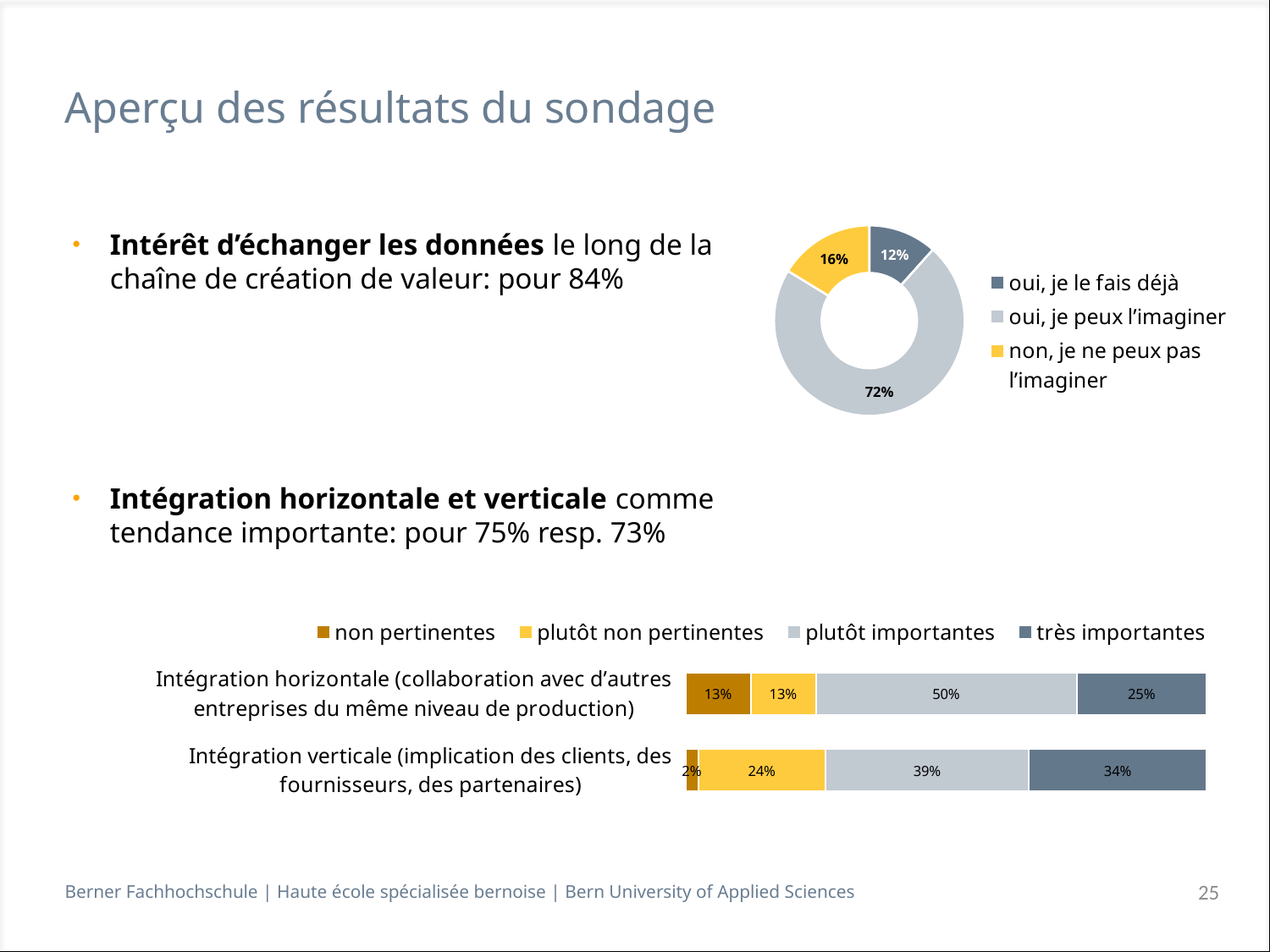
In the donut chart at the top right, what is the difference between the shares for "non, je ne peux pas l'imaginer" and "oui, je le fais déjà"? 4% What kind of chart is shown at the bottom of the slide? Stacked bar chart In the donut chart at the top right, what share is labelled for "oui, je le fais déjà"? 12% In the stacked bar chart at the bottom, which has the larger "plutôt non pertinentes" value: Intégration horizontale or Intégration verticale? Intégration verticale In the stacked bar chart at the bottom, how many series does the legend list? 4 In the donut chart at the top right, which category has the smallest share? oui, je le fais déjà In the stacked bar chart at the bottom, what is the value of "très importantes" for Intégration verticale? 34% In the stacked bar chart at the bottom, what is the difference between the "très importantes" values for Intégration verticale and Intégration horizontale? 9% In the donut chart at the top right, how many categories does the legend list? 3 In the donut chart at the top right, what share is labelled for "oui, je peux l'imaginer"? 72% In the donut chart at the top right, which category has the largest share? oui, je peux l'imaginer In the stacked bar chart at the bottom, what is the value of "plutôt importantes" for Intégration horizontale? 50%